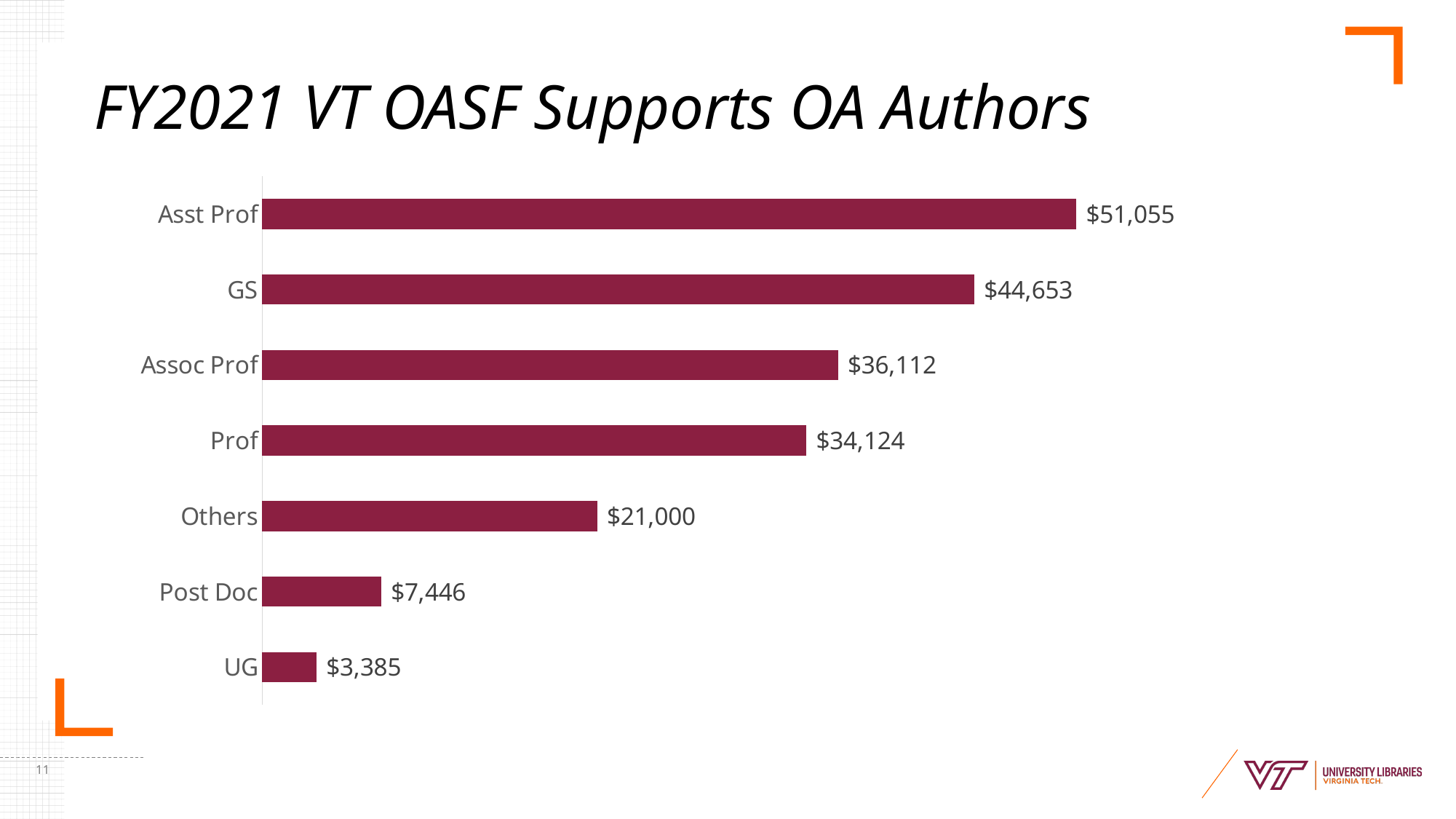
What is the difference between the values for Assoc Prof and Prof? $1,988 Which is larger, the value for Prof or the value for Others? Prof What is the title of the slide? FY2021 VT OASF Supports OA Authors What is the value for Asst Prof? $51,055 What kind of chart is shown on the slide? Bar chart How many categories are shown in the chart? 7 Which category has the highest value? Asst Prof What is the difference between the values for Asst Prof and GS? $6,402 Which category has the lowest value? UG What is the value for GS? $44,653 What is the value for Post Doc? $7,446 What is the value for Others? $21,000